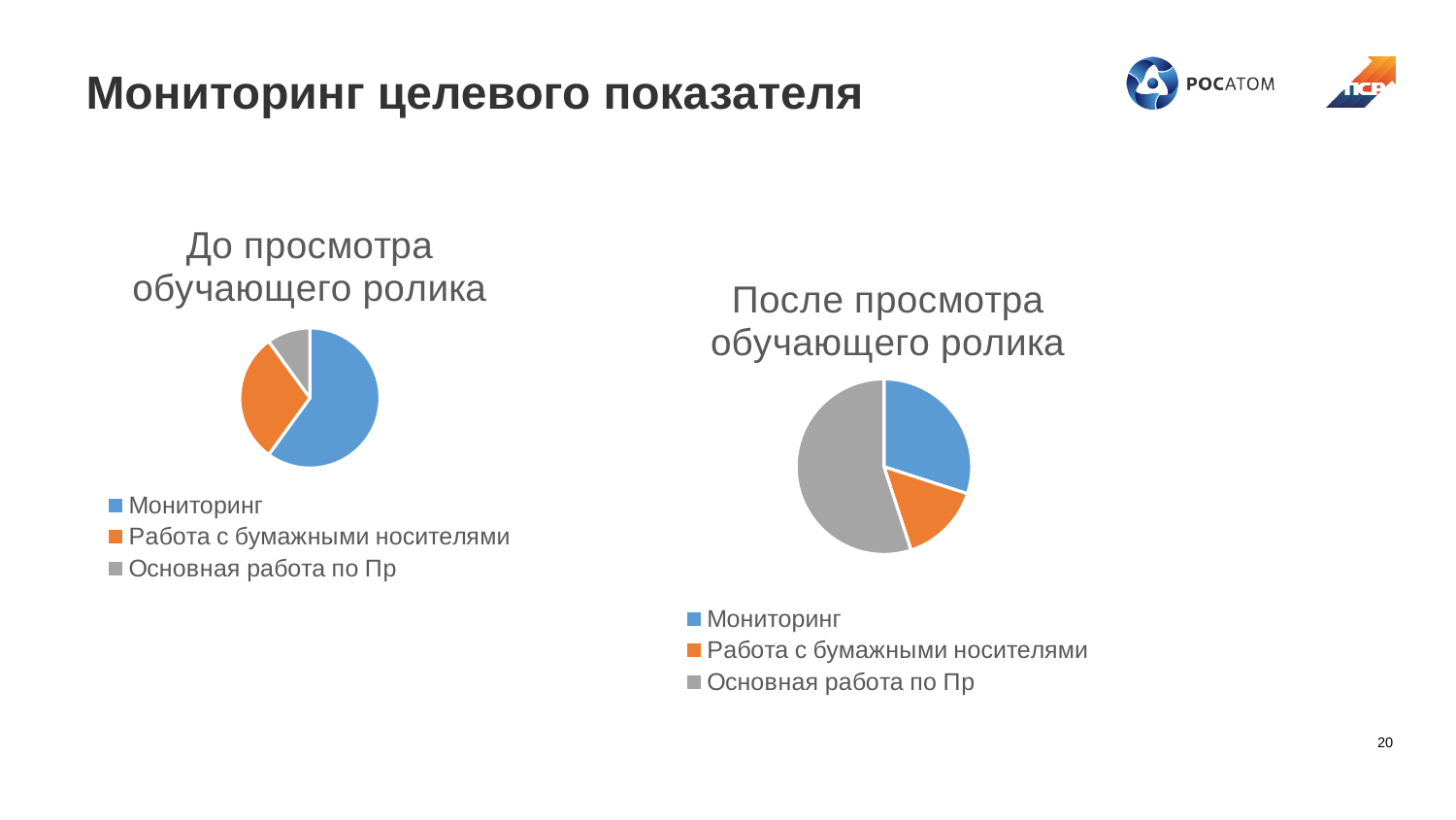
What is the title of the pie chart on the left side of the slide? До просмотра обучающего ролика In the chart titled "После просмотра обучающего ролика", which category has the smallest slice? Работа с бумажными носителями In the chart titled "После просмотра обучающего ролика", which category has the largest slice? Основная работа по Пр In the chart titled "До просмотра обучающего ролика", which slice is larger: Мониторинг or Работа с бумажными носителями? Мониторинг In the chart titled "До просмотра обучающего ролика", which category has the largest slice? Мониторинг In the chart titled "После просмотра обучающего ролика", how many entries does the legend list? 3 In the chart titled "До просмотра обучающего ролика", how many slices does the pie have? 3 What kind of chart is the chart titled "До просмотра обучающего ролика"? pie chart What kind of chart is the chart titled "После просмотра обучающего ролика"? pie chart In the chart titled "После просмотра обучающего ролика", what colour is the slice for Работа с бумажными носителями? orange In the chart titled "После просмотра обучающего ролика", which slice is larger: Мониторинг or Основная работа по Пр? Основная работа по Пр In the chart titled "До просмотра обучающего ролика", which category has the smallest slice? Основная работа по Пр